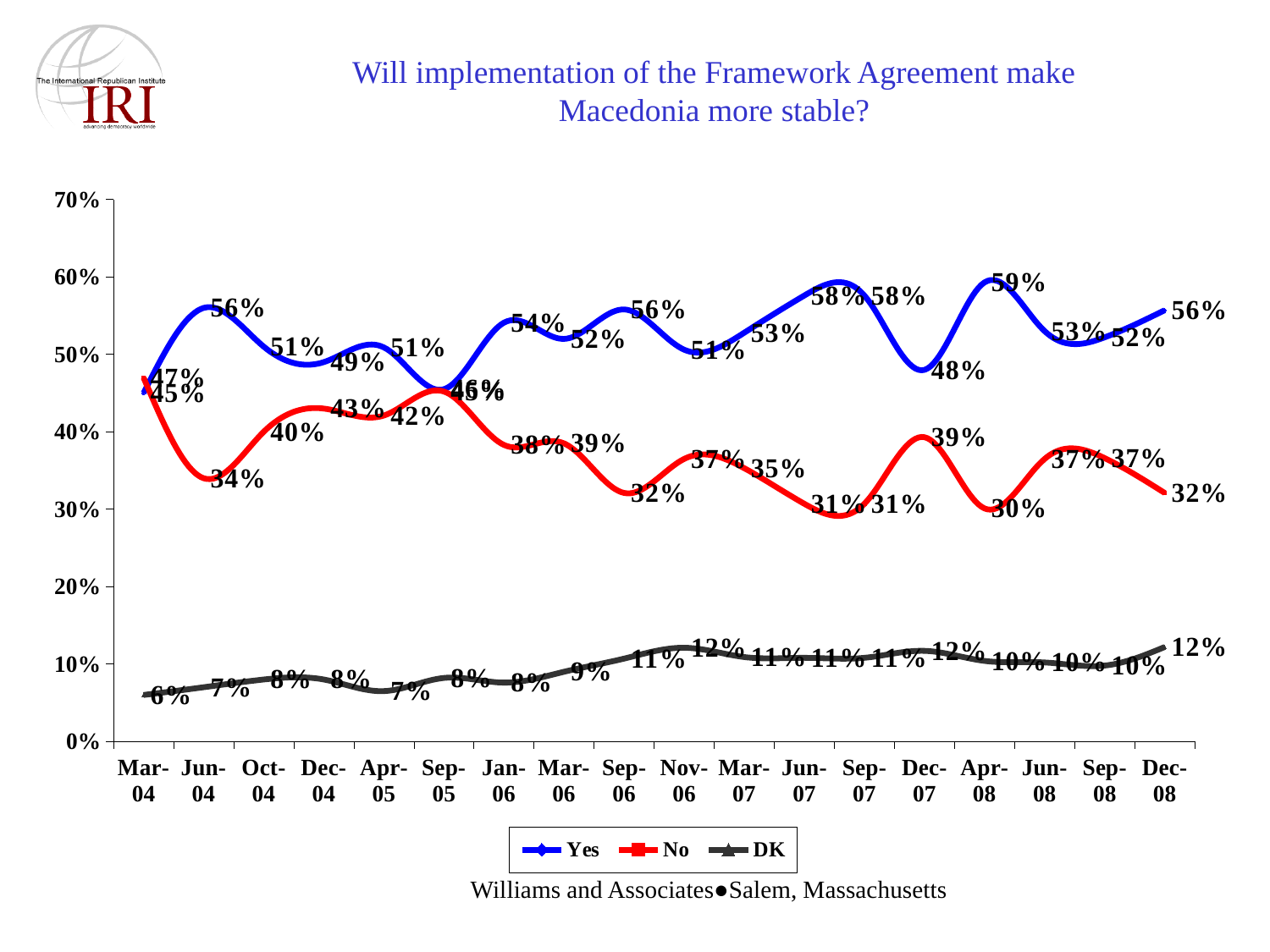
What kind of chart is shown on the slide? line chart At which date does the No series reach its lowest value? Apr-08 How many series does the legend list? 3 What is the value of the Yes series at Apr-08? 59% What is the value of the Yes series at Dec-07? 48% Which is larger: the Yes value at Jun-04 or the Yes value at Dec-07? Jun-04 At which date does the Yes series reach its highest value? Apr-08 What are the three entries in the legend? Yes, No, DK At Dec-08, how many percentage points higher is Yes than No? 24 percentage points What is the value of the No series at Jun-04? 34% What is the value of the DK series at Dec-08? 12% How many survey dates are plotted along the x axis? 18